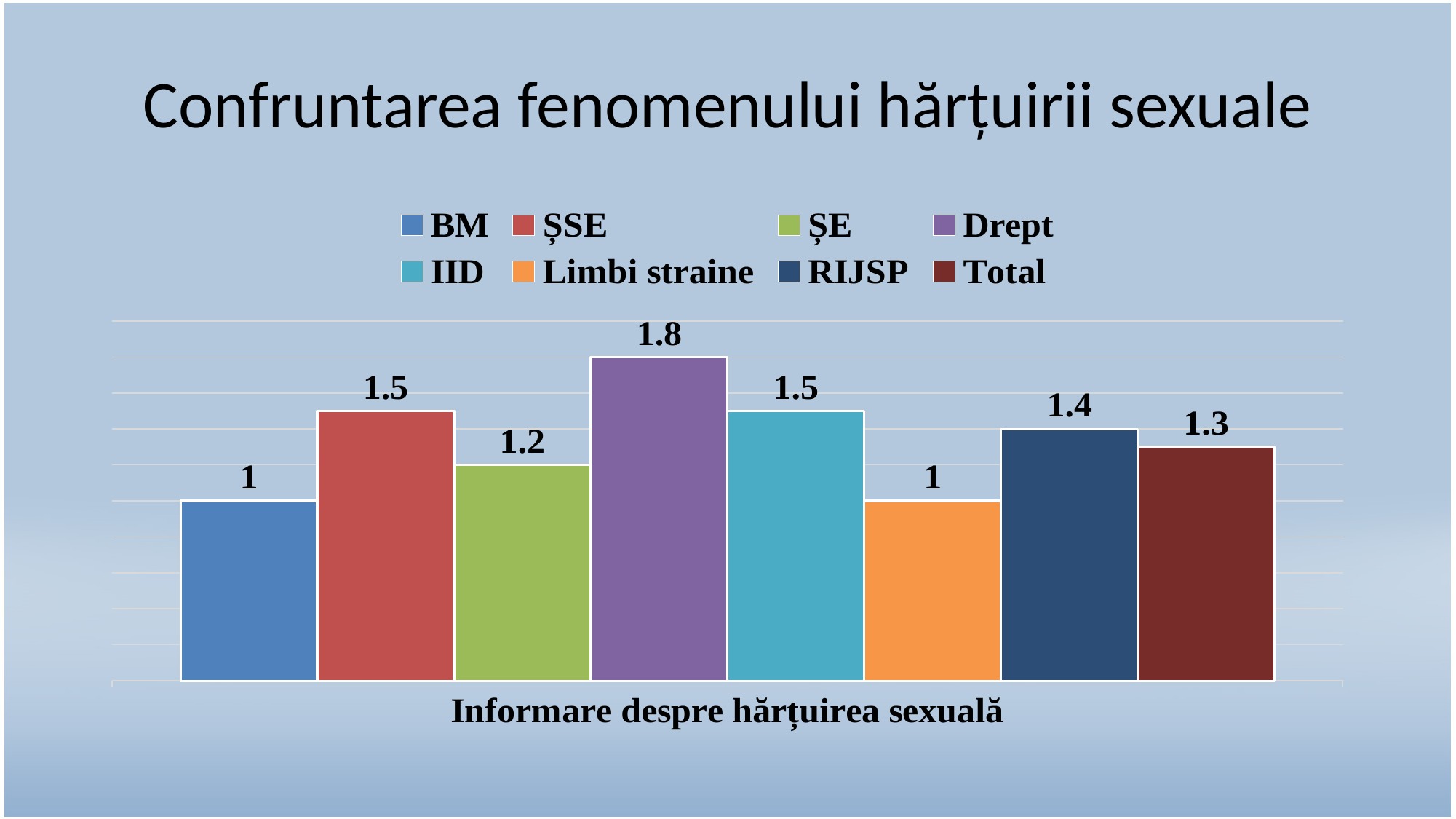
What is the value for RIJSP in the chart? 1.4 What is the difference between the values for RIJSP and Total? 0.1 What is the difference between the values for Drept and BM? 0.8 What is the label on the x axis of the chart? Informare despre hărțuirea sexuală Which is larger, the value for Limbi straine or the value for Total? Total Which series has the highest value in the chart? Drept What kind of chart is shown on the slide? Bar chart How many series does the legend list? 8 What is the value for ȘE in the chart? 1.2 What is the value for Drept in the chart? 1.8 Which is larger, the value for ȘSE or the value for ȘE? ȘSE What is the value for Total in the chart? 1.3